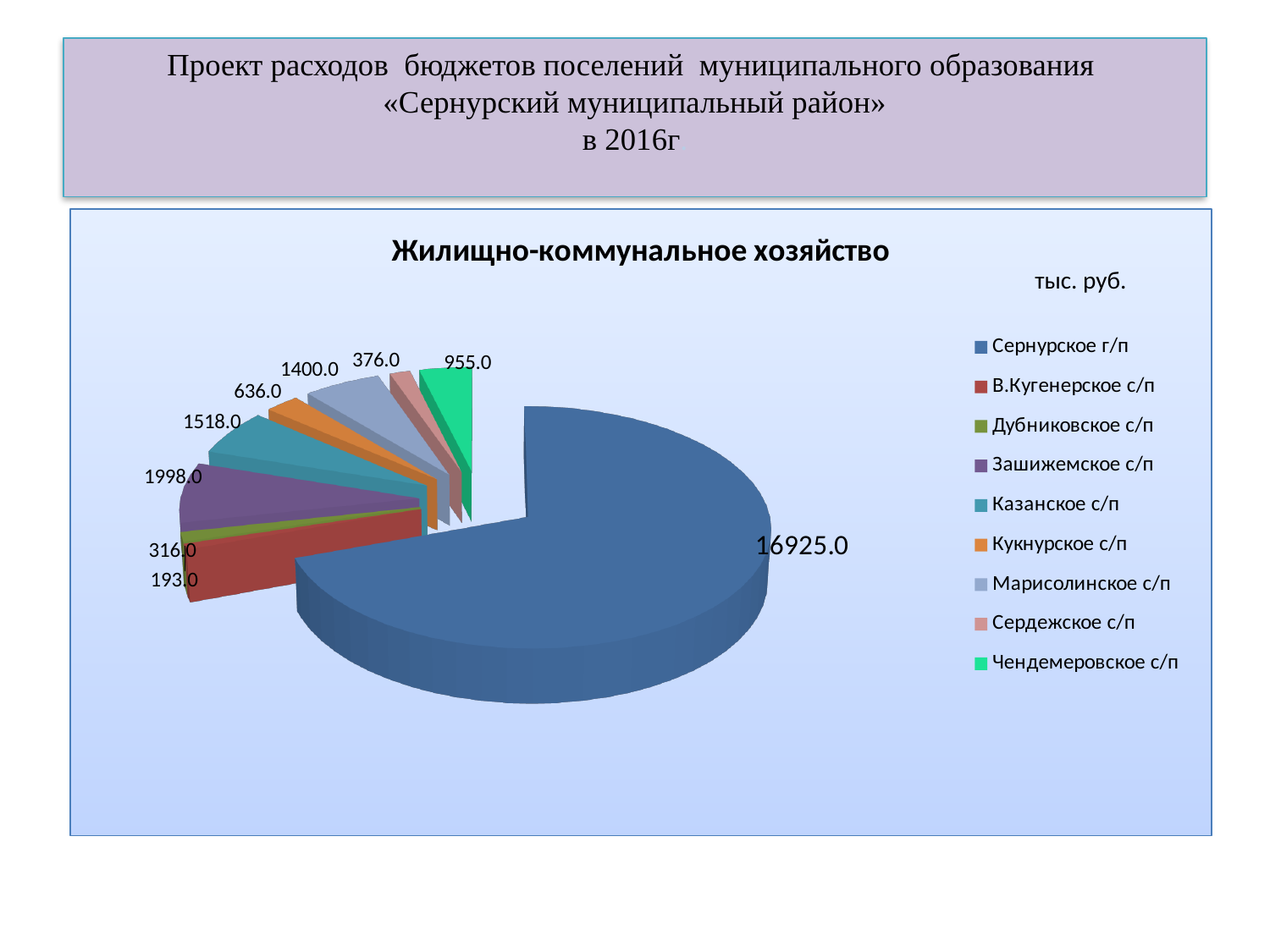
What is the title of the pie chart? Жилищно-коммунальное хозяйство How many categories (settlements) does the legend of the pie chart list? 9 Which settlement has the largest slice in the pie chart? Сернурское г/п In what units are the values of the pie chart given? тыс. руб. Which is larger, the value for Кукнурское с/п or for Сердежское с/п? Кукнурское с/п What is the value shown for Марисолинское с/п? 1400.0 What is the difference between the values for Зашижемское с/п and Казанское с/п? 480.0 What kind of chart is shown on the slide? pie chart What is the value shown for Сернурское г/п? 16925.0 What is the value shown for Чендемеровское с/п? 955.0 What is the value shown for Казанское с/п? 1518.0 What is the value shown for Зашижемское с/п? 1998.0